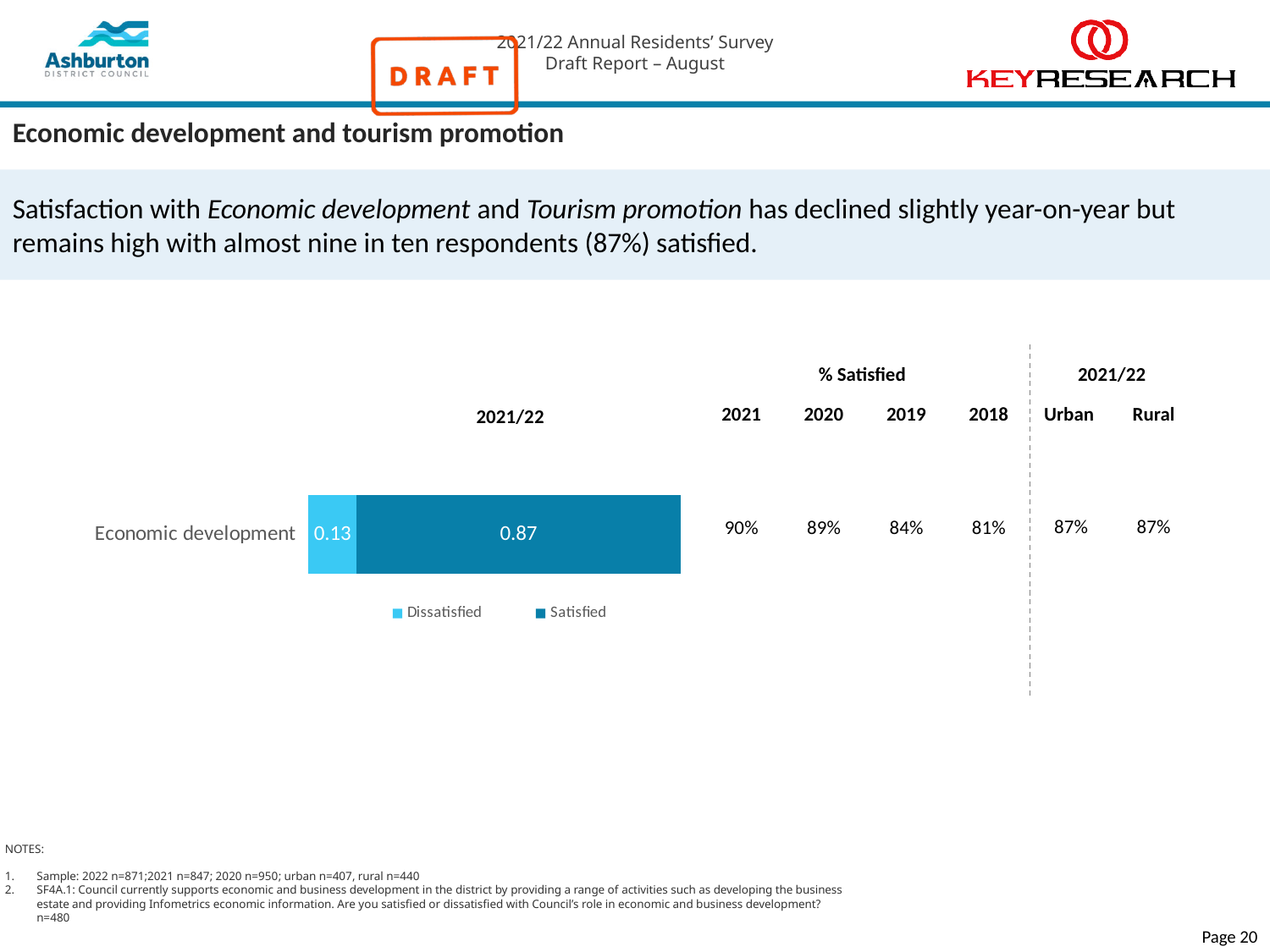
In the % Satisfied table next to the chart, which year had the highest % Satisfied? 2021 What is the Satisfied value for Economic development in the 2021/22 bar chart? 0.87 In the 2021/22 bar chart, what is the difference between the Satisfied and Dissatisfied values for Economic development? 0.74 In the 2021/22 bar chart, which segment is larger for Economic development, Satisfied or Dissatisfied? Satisfied What is the title of the chart on the slide? 2021/22 What kind of chart is shown on the slide? Stacked bar chart What are the two legend entries of the chart? Dissatisfied, Satisfied How many series does the legend of the 2021/22 chart list? 2 What is the Dissatisfied value for Economic development in the 2021/22 bar chart? 0.13 In the % Satisfied table next to the chart, what was the % Satisfied in 2018? 81% How many categories are plotted in the 2021/22 bar chart? 1 What is the total of the stacked bar for Economic development in the 2021/22 chart? 1.00